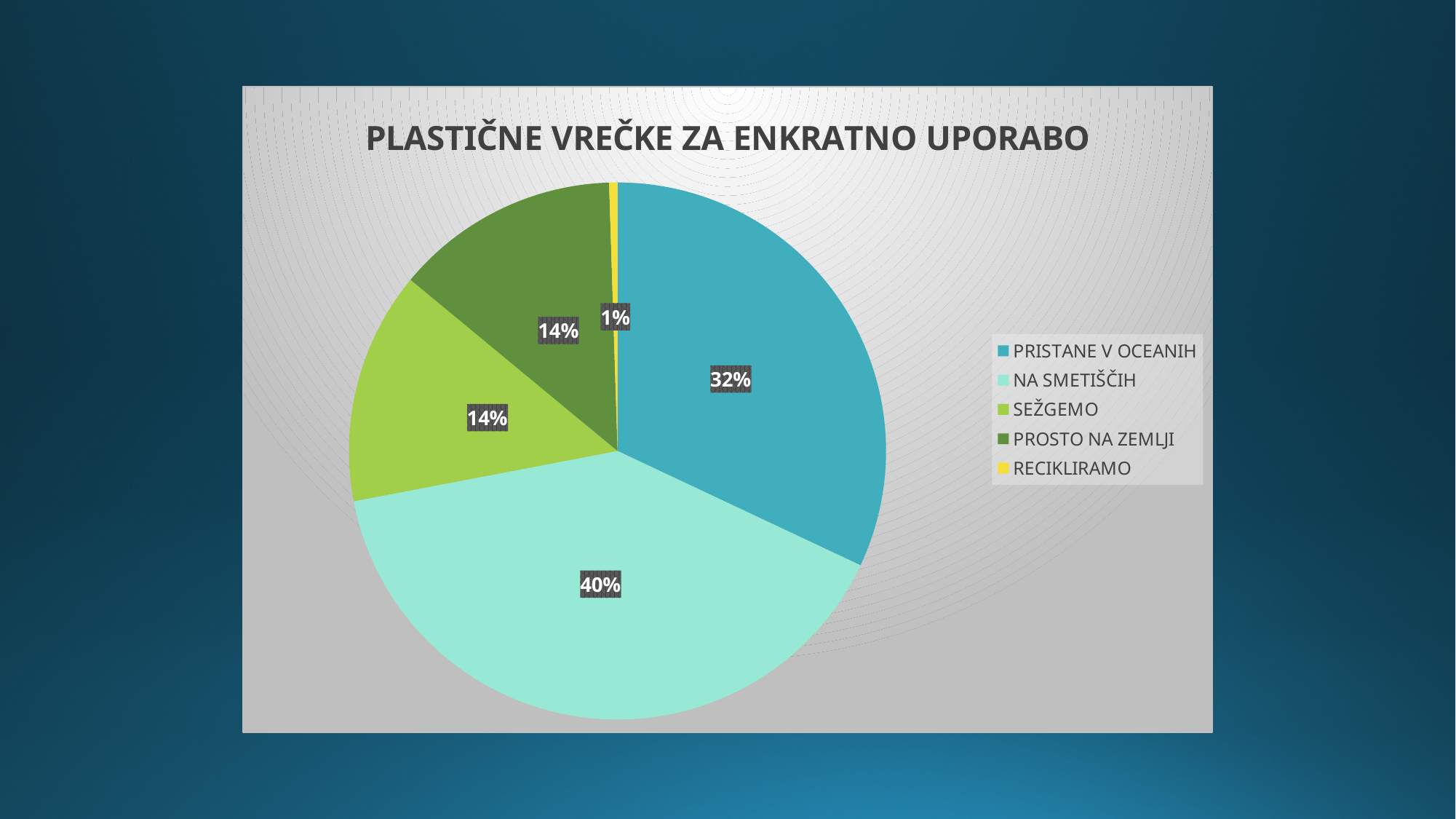
What kind of chart is shown on the slide? Pie chart Which category has the largest slice? NA SMETIŠČIH What is the value shown for PRISTANE V OCEANIH? 32% What is the value shown for RECIKLIRAMO? 1% What is the difference between the NA SMETIŠČIH and PRISTANE V OCEANIH slices? 8% What share of the pie does NA SMETIŠČIH take? 40% What is the title of the chart? PLASTIČNE VREČKE ZA ENKRATNO UPORABO How many categories does the pie chart show? 5 Which category has the smallest slice? RECIKLIRAMO Which is larger, PRISTANE V OCEANIH or PROSTO NA ZEMLJI? PRISTANE V OCEANIH What colour is the RECIKLIRAMO slice? Yellow What is the value shown for SEŽGEMO? 14%